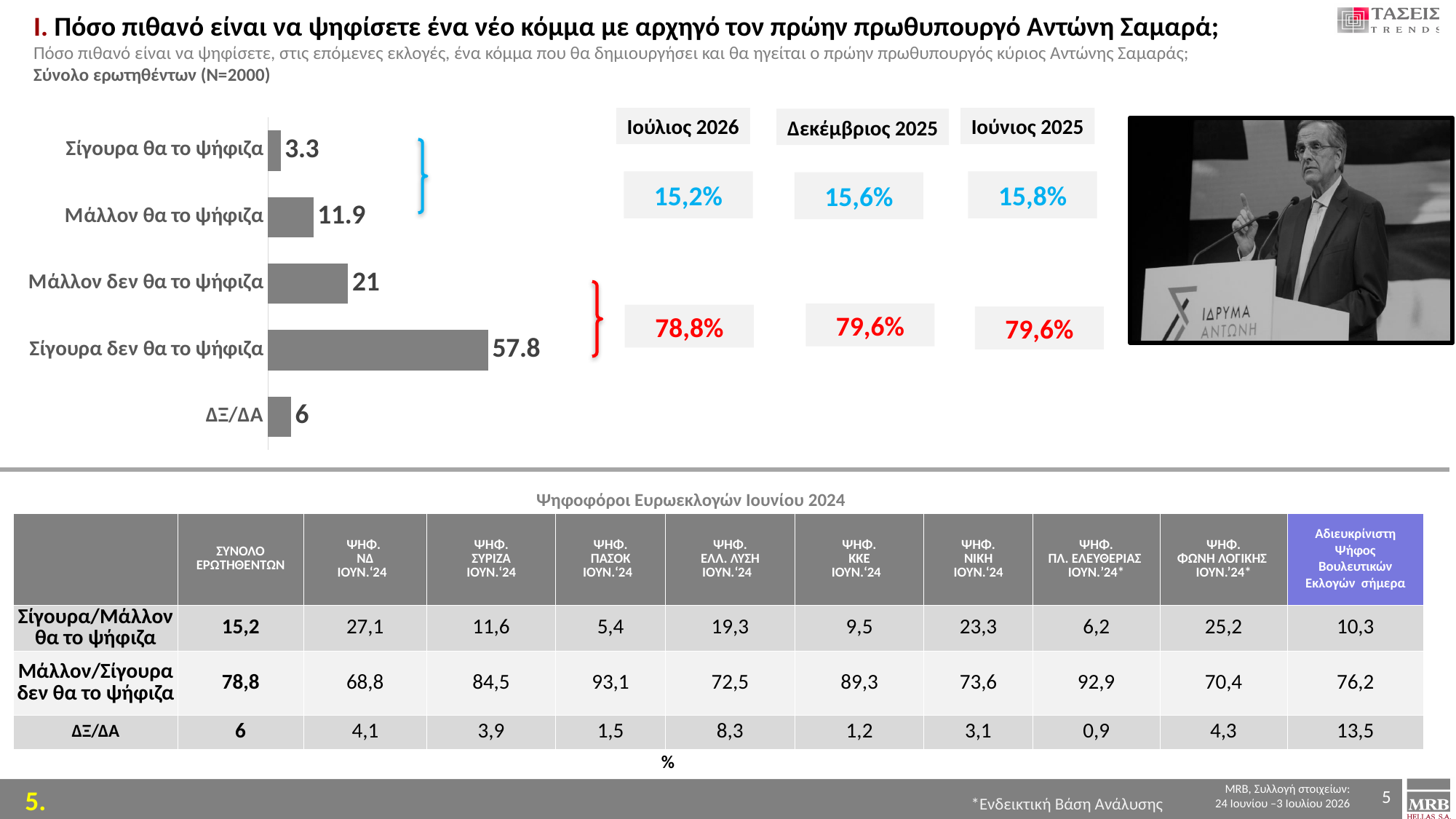
What is the value for "Σίγουρα δεν θα το ψήφιζα" in the bar chart? 57.8 What is the difference between the values for "Σίγουρα δεν θα το ψήφιζα" and "Μάλλον δεν θα το ψήφιζα" in the bar chart? 36.8 Which category has the lowest value in the bar chart? Σίγουρα θα το ψήφιζα What is the combined value of "Σίγουρα θα το ψήφιζα" and "Μάλλον θα το ψήφιζα" in the bar chart? 15.2 What is the value for "Μάλλον θα το ψήφιζα" in the bar chart? 11.9 What is the value for "Σίγουρα θα το ψήφιζα" in the bar chart? 3.3 What type of chart is shown on the slide? bar chart What is the difference between the values for "Μάλλον θα το ψήφιζα" and "Σίγουρα θα το ψήφιζα" in the bar chart? 8.6 How many categories are shown in the bar chart? 5 What is the value for "ΔΞ/ΔΑ" in the bar chart? 6 Which category has the highest value in the bar chart? Σίγουρα δεν θα το ψήφιζα Which is larger in the bar chart: the value for "ΔΞ/ΔΑ" or the value for "Σίγουρα θα το ψήφιζα"? ΔΞ/ΔΑ